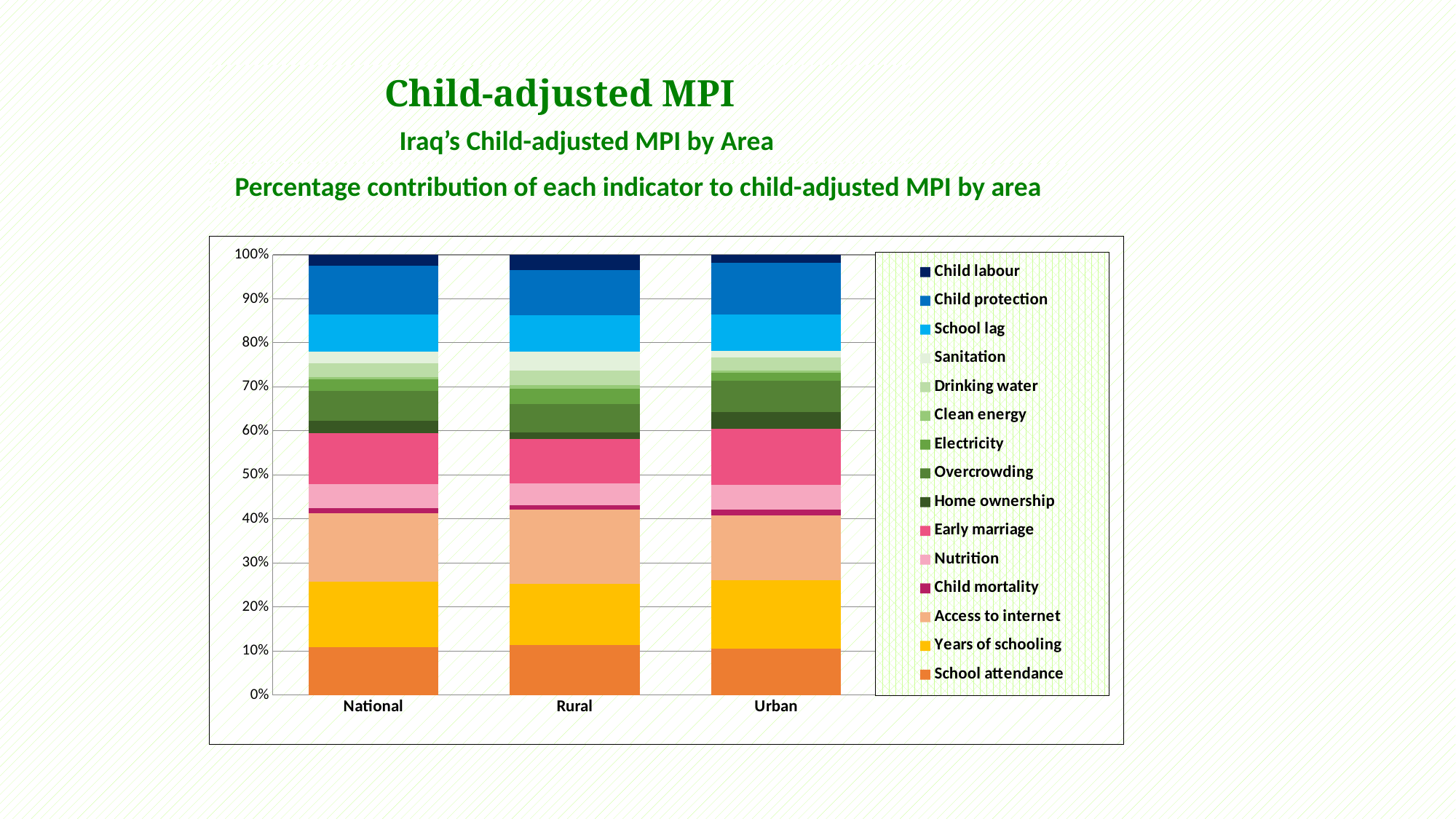
What is the title printed above the chart? Percentage contribution of each indicator to child-adjusted MPI by area Is the School attendance contribution for Rural greater or less than 20%? less Which area has the smallest Sanitation segment? Urban Which area has the largest Sanitation segment? Rural How many areas (categories) are shown on the x axis? 3 What is the total height of the National bar? 100% Is the Home ownership segment larger for Rural or for Urban? Urban What kind of chart is shown on the slide? Stacked bar chart How many indicators does the legend list? 15 Which indicator forms the bottom segment of each bar? School attendance Is the Access to internet segment larger for Rural or for Urban? Rural